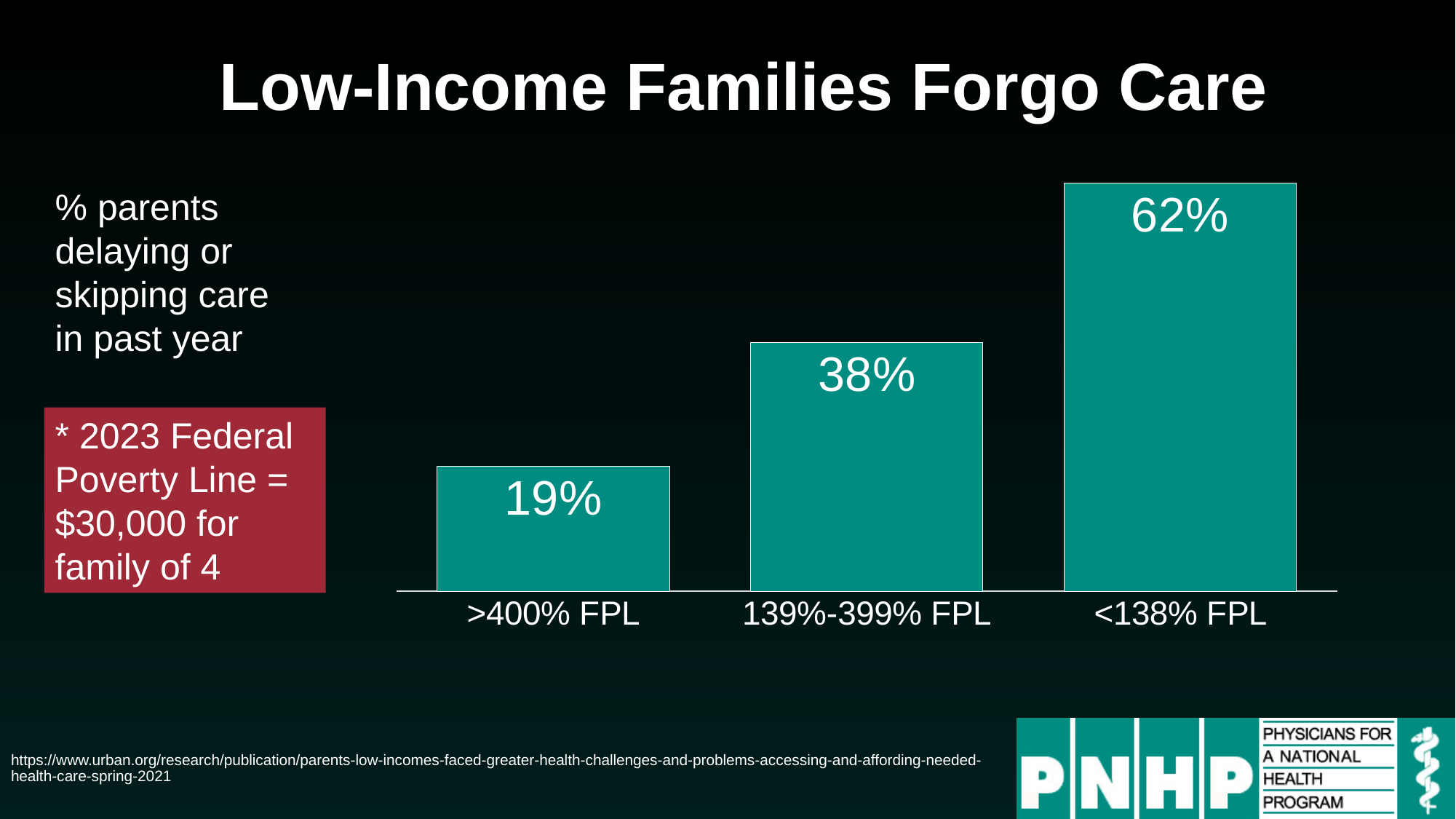
What is the title of the slide containing the chart? Low-Income Families Forgo Care What is the difference in percentage points between the 139%-399% FPL and >400% FPL categories? 19 Which income category has the highest percentage of parents delaying or skipping care? <138% FPL How many income categories are shown in the chart? 3 What is the difference in percentage points between the <138% FPL and >400% FPL categories? 43 What percentage of parents with income >400% FPL delayed or skipped care in the past year? 19% What kind of chart is shown on the slide? Bar chart What is the value shown for the 139%-399% FPL category? 38% What is the value shown for the <138% FPL category? 62% Do the values rise or fall moving from left to right across the categories? Rise Which is larger, the value for 139%-399% FPL or the value for >400% FPL? 139%-399% FPL Which income category has the lowest percentage of parents delaying or skipping care? >400% FPL